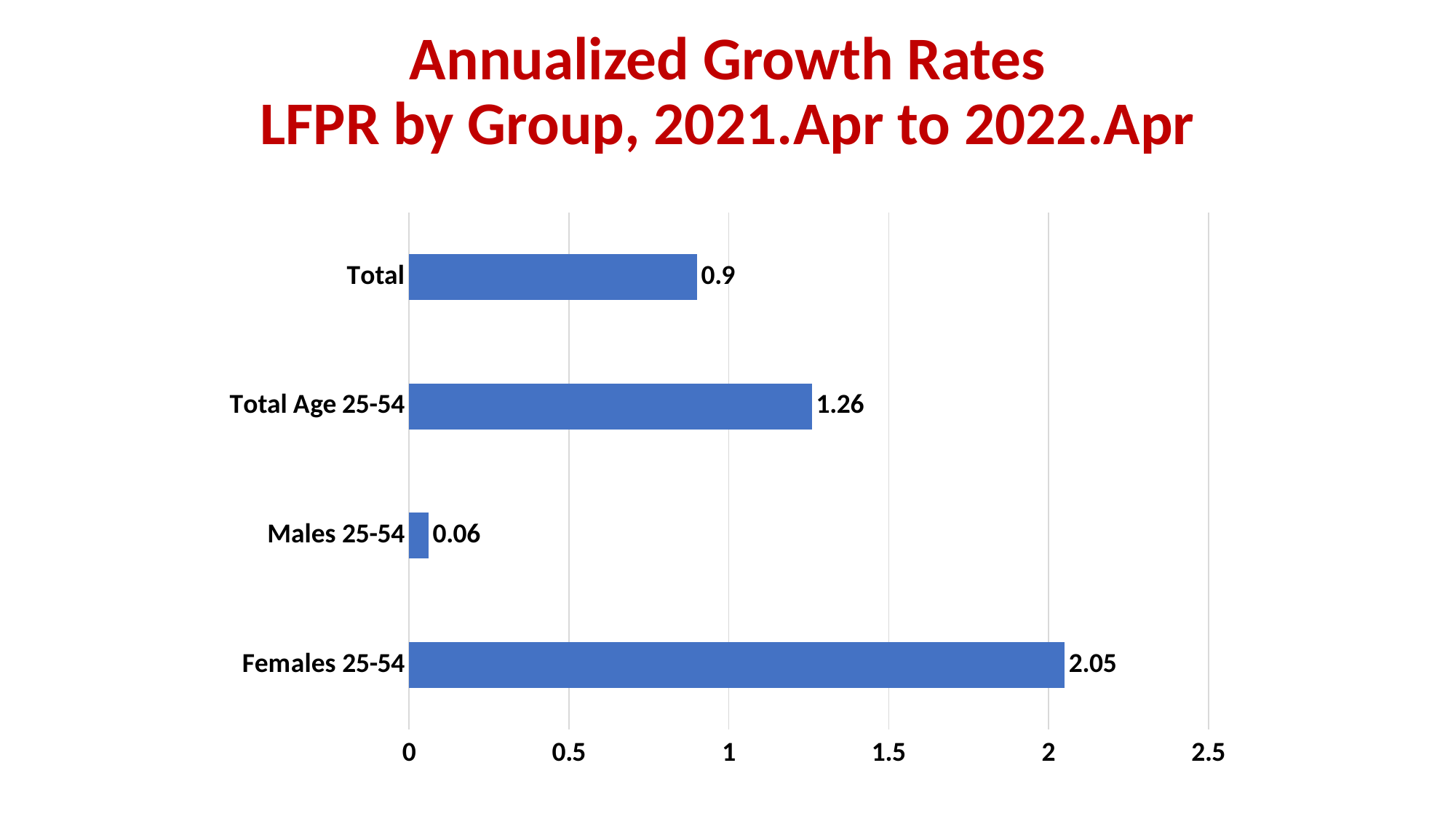
What is the difference between the values for Total Age 25-54 and Total? 0.36 Which is larger, the value for Total or the value for Total Age 25-54? Total Age 25-54 What is the difference between the values for Females 25-54 and Males 25-54? 1.99 What is the value shown for Total? 0.9 Is the value for Females 25-54 greater or less than 2? greater Which group has the lowest annualized growth rate? Males 25-54 What is the annualized growth rate for Females 25-54? 2.05 Which group has the highest annualized growth rate? Females 25-54 What is the annualized growth rate for Males 25-54? 0.06 What kind of chart is shown on the slide? Bar chart What is the value shown for Total Age 25-54? 1.26 How many groups are shown in the chart? 4